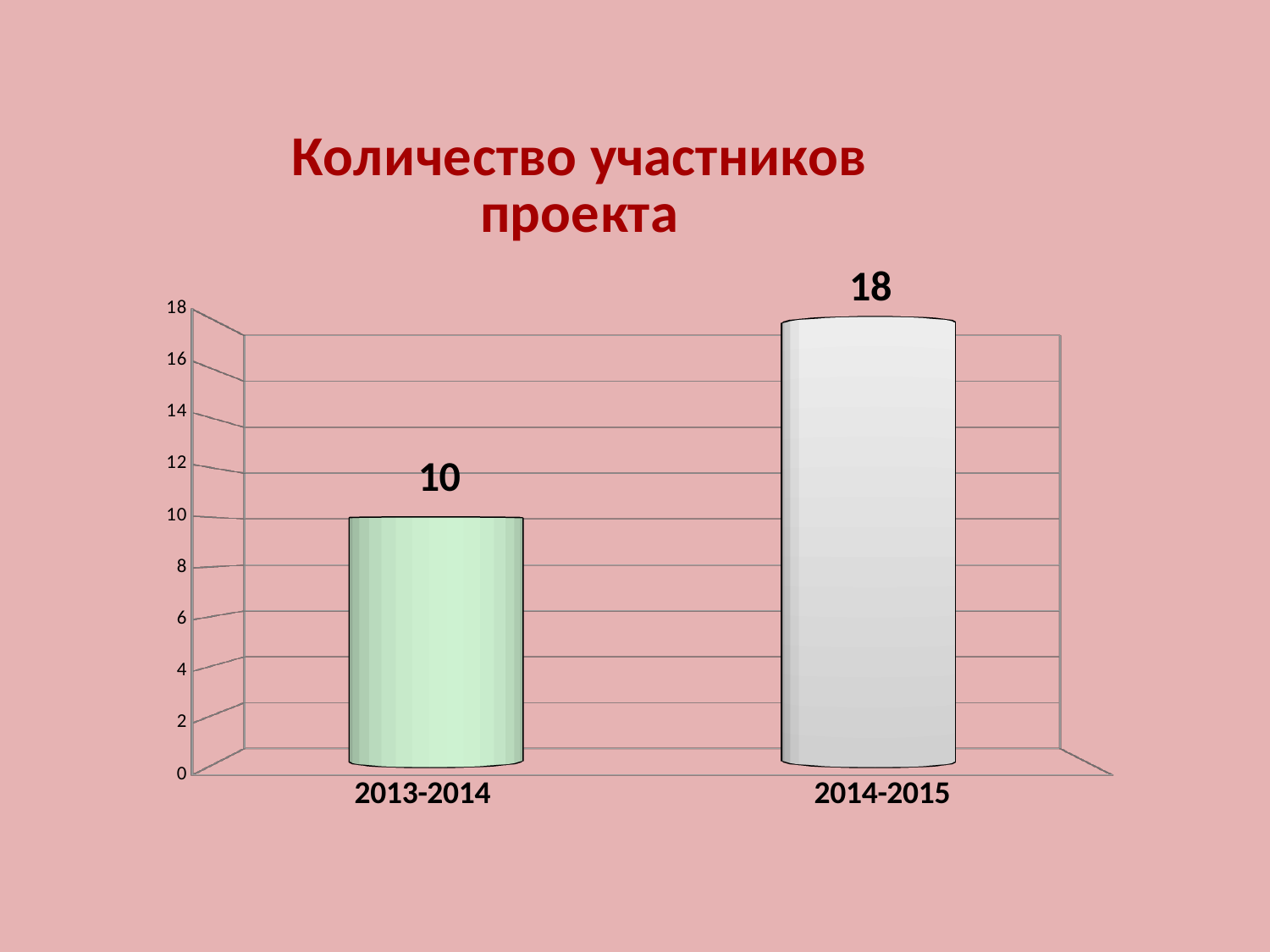
What is the value for 2013-2014? 10 Which category has the lowest value? 2013-2014 Which is larger, the value for 2013-2014 or the value for 2014-2015? 2014-2015 Is the value for 2013-2014 greater or less than 12? less Which category has the highest value? 2014-2015 What is the value for 2014-2015? 18 What is the title of the chart? Количество участников проекта Do the values rise or fall from 2013-2014 to 2014-2015? rise Is the value for 2014-2015 greater or less than 16? greater How many categories are shown on the x axis? 2 What kind of chart is shown on the slide? bar chart What is the difference between the values for 2014-2015 and 2013-2014? 8